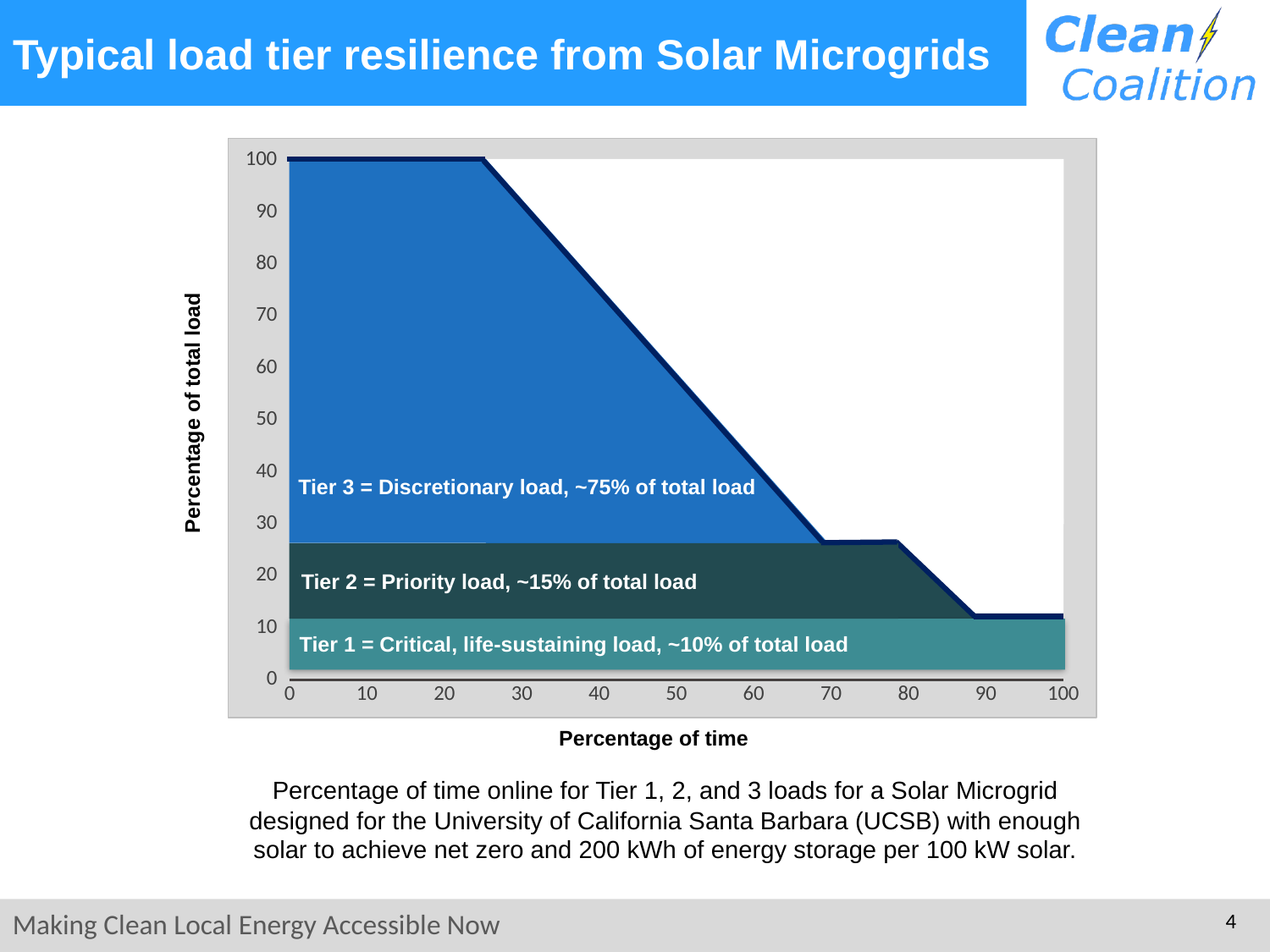
Is the percentage of total load at 40% of time greater or less than 60? greater According to the chart label, what share of total load is Tier 2 (Priority load)? ~15% According to the chart label, what share of total load is Tier 3 (Discretionary load)? ~75% Is the percentage of total load at 100% of time greater or less than 20? less How many load tiers are labelled on the chart? 3 Is the percentage of total load at 80% of time greater or less than 40? less According to the chart label, what share of total load is Tier 1 (Critical, life-sustaining load)? ~10% What is the label of the y axis of the chart? Percentage of total load Overall, does the plotted percentage of total load rise or fall as the percentage of time increases? Fall What is the label of the x axis of the chart? Percentage of time What kind of chart is shown on the slide? Area chart